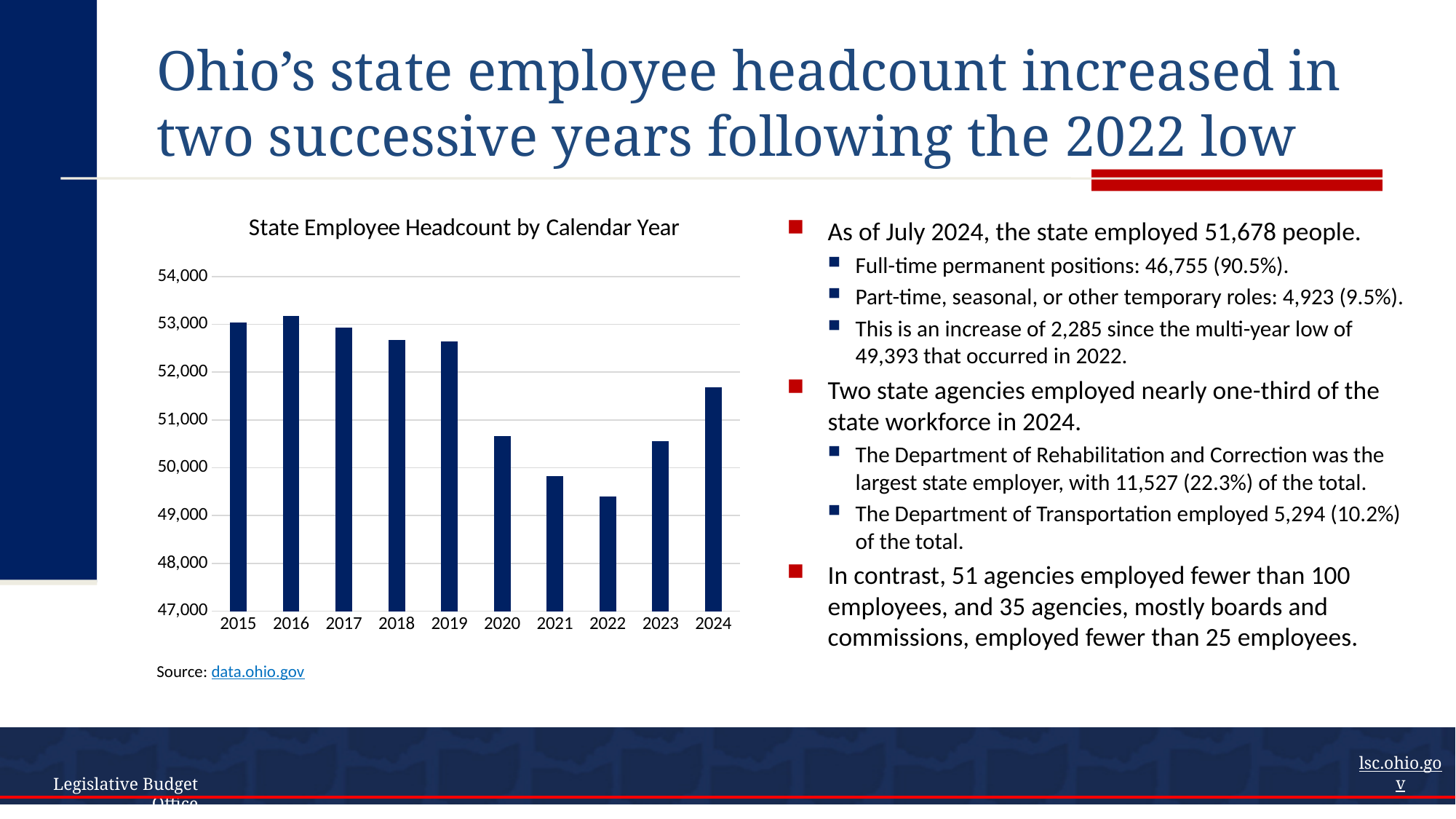
What is the title of the chart? State Employee Headcount by Calendar Year Does the headcount rise or fall from 2022 to 2024? rise How many years are shown on the x axis of the chart? 10 Which year has the lowest state employee headcount in the chart? 2022 Which year has the highest state employee headcount in the chart? 2016 Is the headcount for 2018 greater or less than 52,000? greater Is the headcount for 2021 greater or less than 50,000? less Which year has a larger headcount, 2019 or 2020? 2019 Is the headcount for 2020 greater or less than 50,000? greater What type of chart is shown on the slide? Bar chart Which year has a larger headcount, 2023 or 2021? 2023